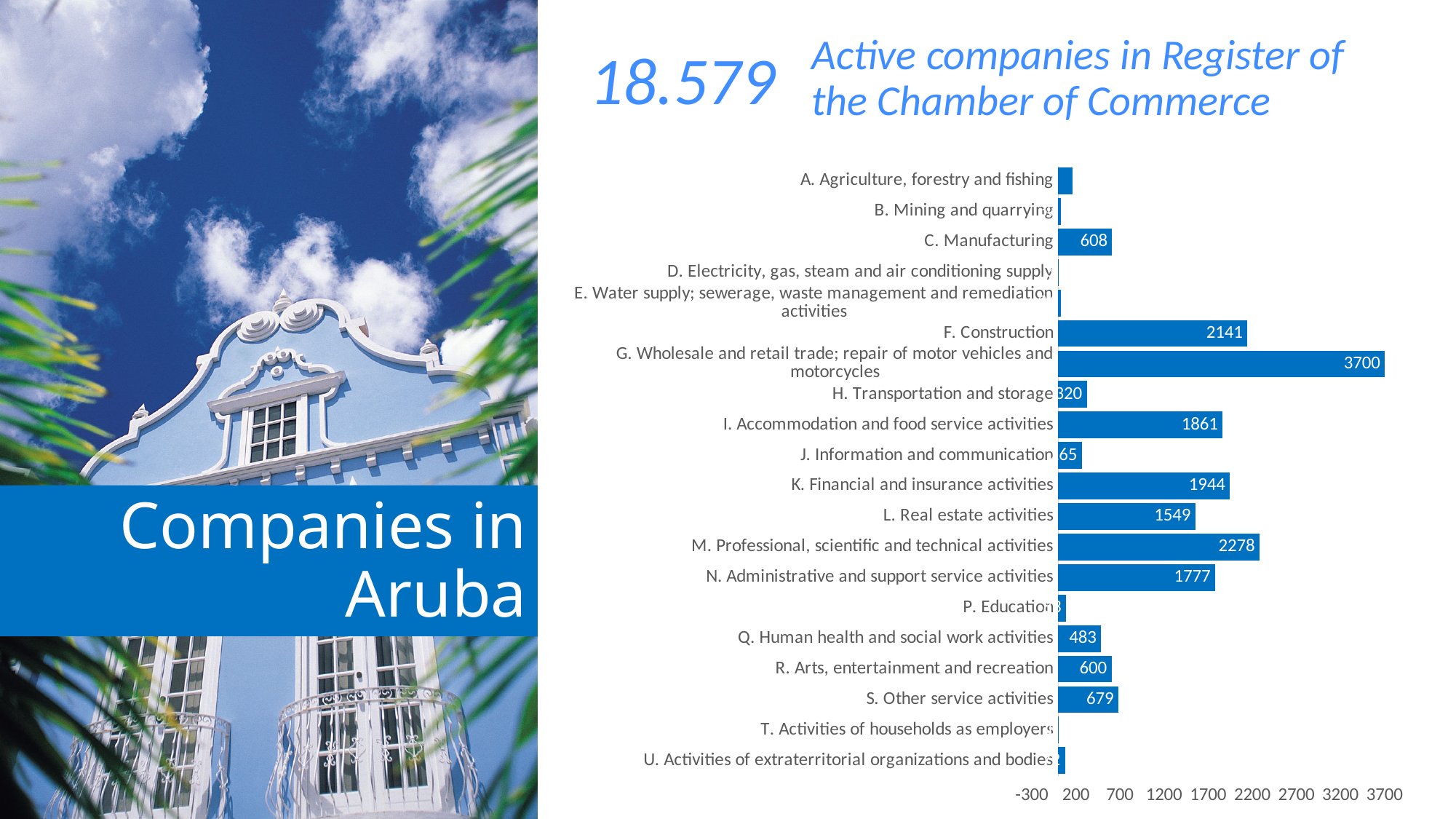
What total number of active companies is stated next to the chart title? 18.579 What is the value for K. Financial and insurance activities? 1944 Which category has the highest number of active companies? G. Wholesale and retail trade; repair of motor vehicles and motorcycles Is the value for Q. Human health and social work activities greater or less than 700? less How many active companies are listed for C. Manufacturing? 608 What is the value for F. Construction? 2141 Which is larger, L. Real estate activities or N. Administrative and support service activities? N. Administrative and support service activities What kind of chart is shown on the slide? bar chart What is the value for N. Administrative and support service activities? 1777 How many categories are shown in the chart? 20 What is the difference between G. Wholesale and retail trade and F. Construction? 1559 What is the difference between M. Professional, scientific and technical activities and K. Financial and insurance activities? 334